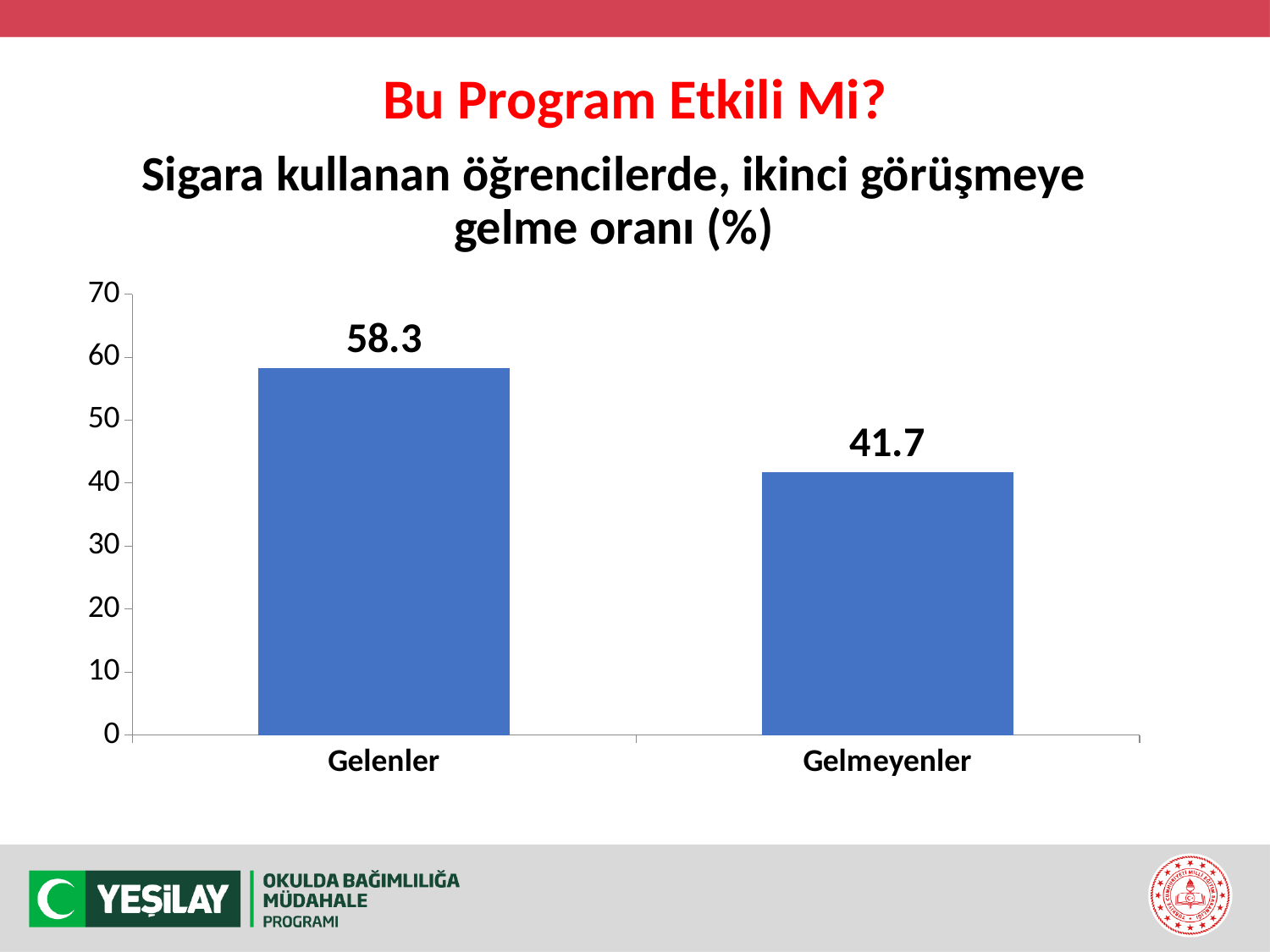
What is the value for Gelmeyenler? 41.7 Which category has the highest value? Gelenler How many categories are shown on the x axis? 2 What kind of chart is shown on the slide? bar chart What is the value for Gelenler? 58.3 What is the difference between the values for Gelenler and Gelmeyenler? 16.6 Is the value for Gelenler greater or less than 50? greater Which is larger, the value for Gelenler or the value for Gelmeyenler? Gelenler Is the value for Gelmeyenler greater or less than 50? less What is the title of the chart? Sigara kullanan öğrencilerde, ikinci görüşmeye gelme oranı (%) Which category has the lowest value? Gelmeyenler What is the maximum value shown on the y axis? 70